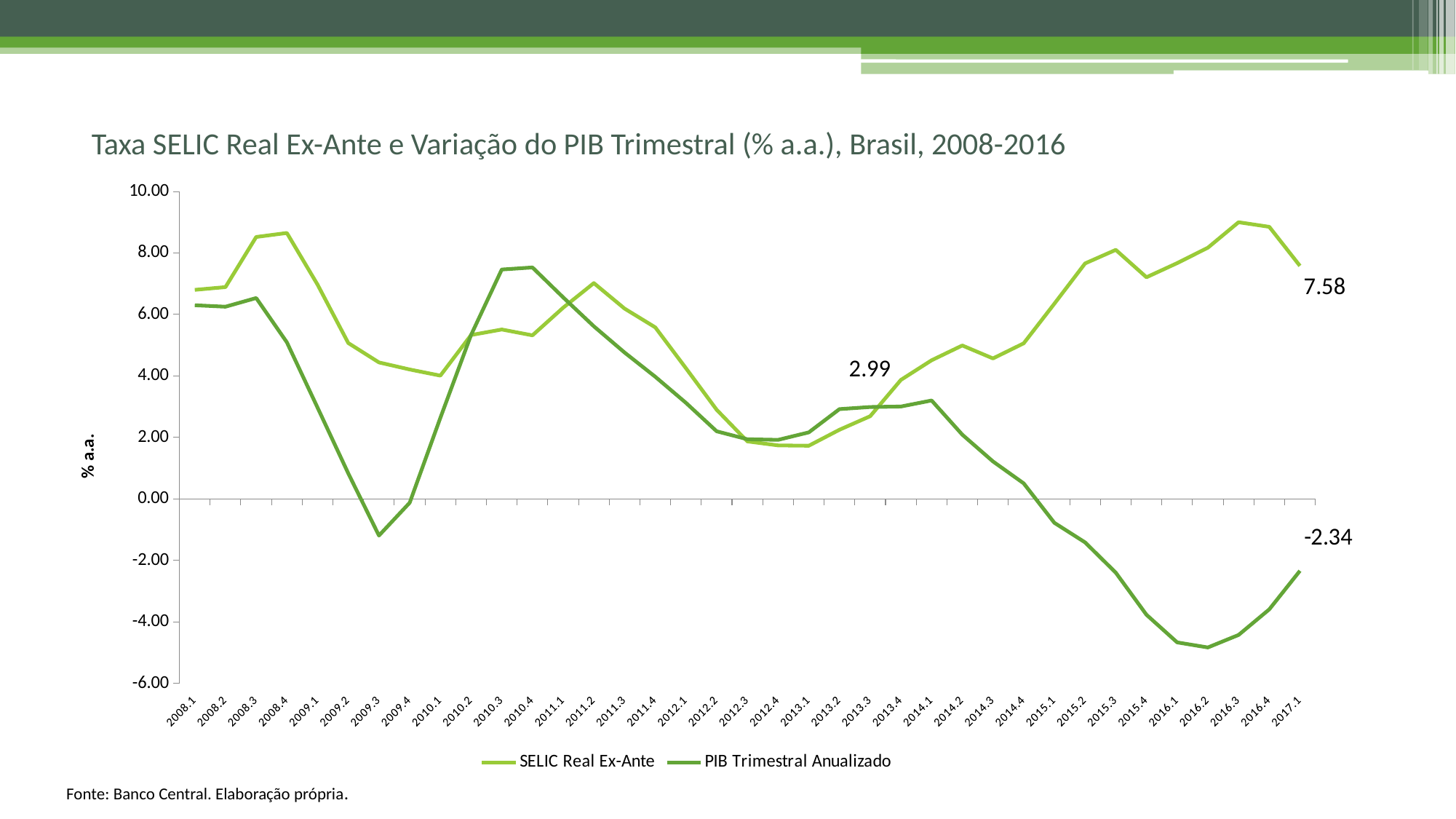
Is the value for SELIC Real Ex-Ante at 2016.3 greater or less than 8.00? greater What is the value of PIB Trimestral Anualizado at 2017.1? -2.34 What kind of chart is shown on the slide? line chart What is the value of SELIC Real Ex-Ante at 2017.1? 7.58 At 2017.1, which series has the larger value, SELIC Real Ex-Ante or PIB Trimestral Anualizado? SELIC Real Ex-Ante Is the value for PIB Trimestral Anualizado at 2009.3 greater or less than 0.00? less How many series does the legend list? 2 Is the value for PIB Trimestral Anualizado at 2016.2 greater or less than -4.00? less What is the difference between SELIC Real Ex-Ante and PIB Trimestral Anualizado at 2017.1? 9.92 Which series reaches the lowest value on the chart? PIB Trimestral Anualizado Does PIB Trimestral Anualizado rise or fall from 2014.1 to 2016.2? fall What is the label on the vertical axis? % a.a.